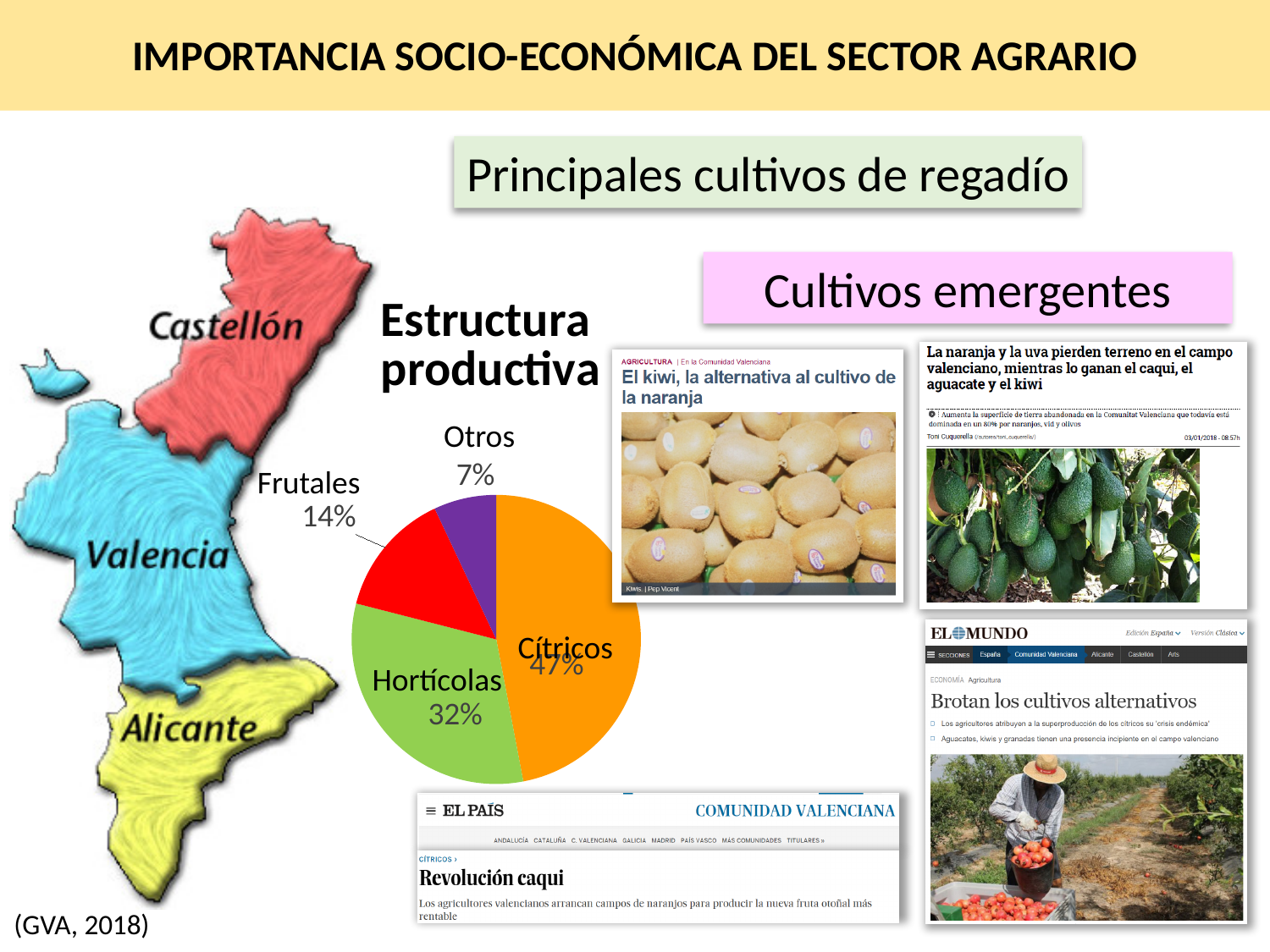
What share of the pie chart does Cítricos represent? 47% Which is larger in the pie chart, Frutales or Otros? Frutales Which category has the smallest slice in the pie chart? Otros What share of the pie chart does Otros represent? 7% Which category has the largest slice in the pie chart? Cítricos What type of chart is shown on the slide? pie chart What share of the pie chart does Hortícolas represent? 32% What heading appears next to the pie chart describing it? Estructura productiva What is the difference in percentage points between Frutales and Otros in the pie chart? 7 What is the difference in percentage points between Cítricos and Hortícolas in the pie chart? 15 What share of the pie chart does Frutales represent? 14% How many categories are shown in the pie chart? 4